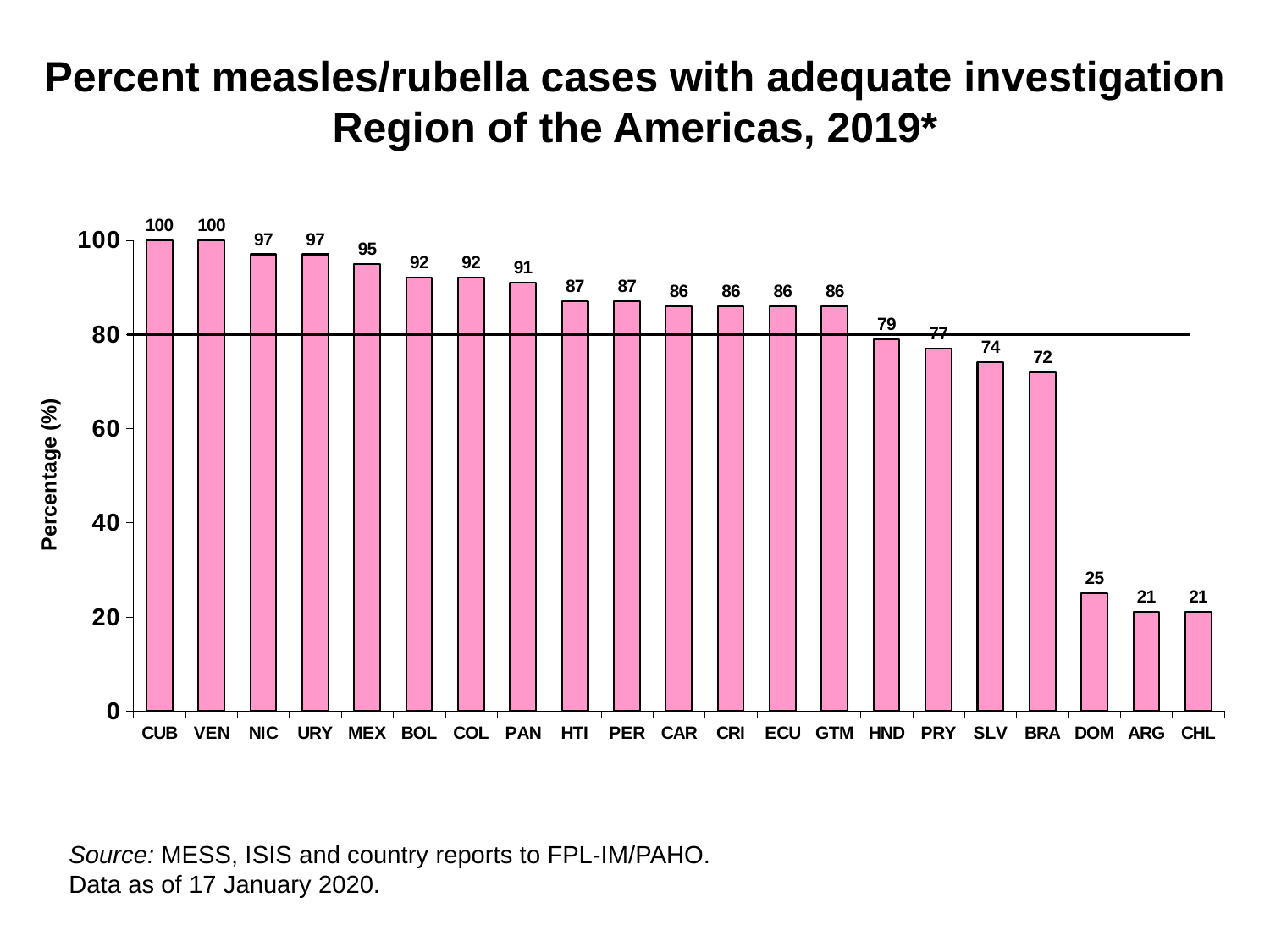
What is the highest value shown on the chart? 100 What is the value for MEX? 95 Which has a larger value, SLV or PRY? PRY How many countries are shown on the x axis? 21 What is the value for HND? 79 Is the value for BRA greater or less than 80? less What is the lowest value shown on the chart? 21 What is the value for DOM? 25 What is the difference between the values for BRA and DOM? 47 What kind of chart is this? bar chart What is the difference between the values for NIC and PAN? 6 What is the label of the y axis? Percentage (%)